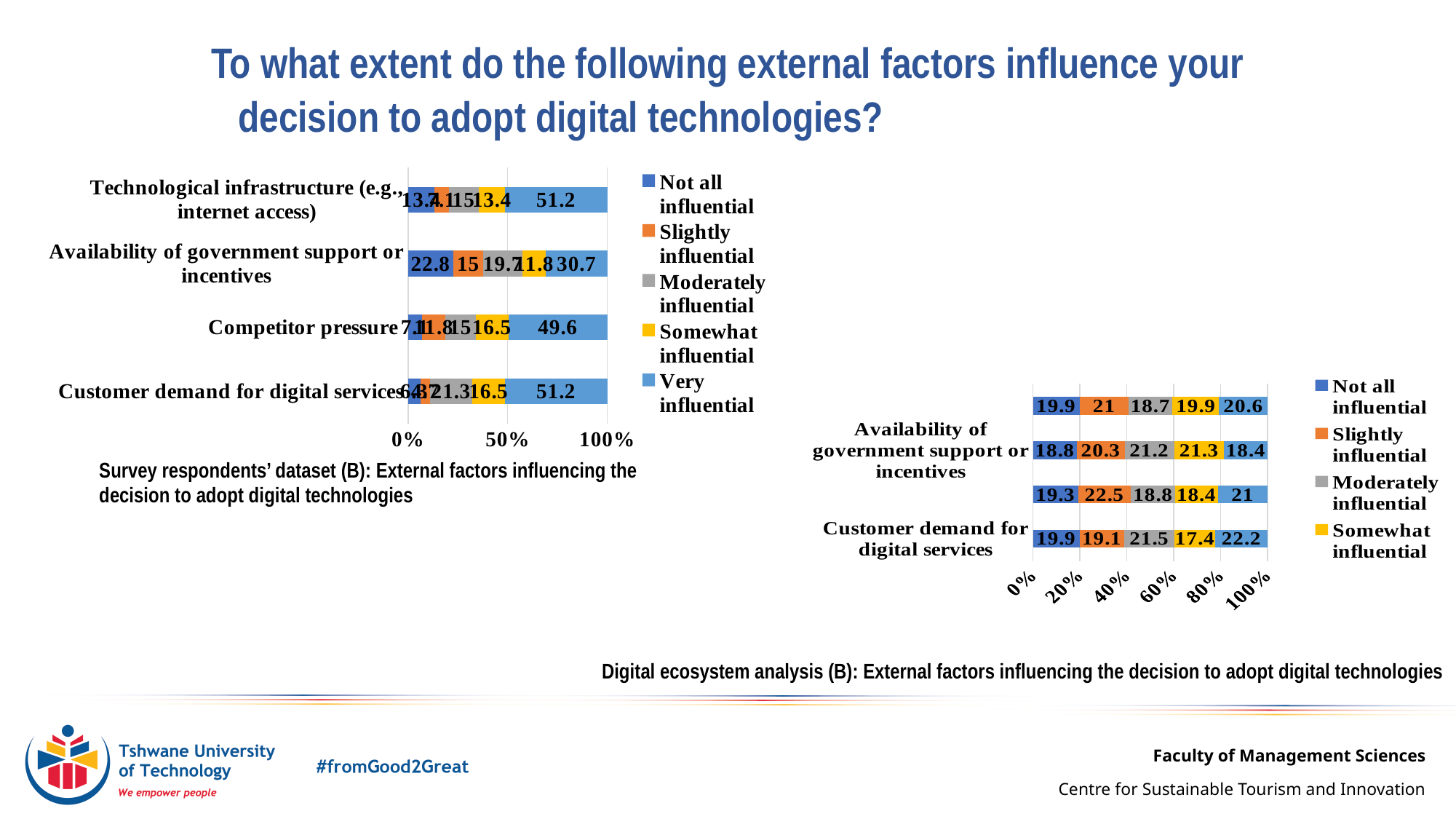
What kind of chart is the left chart (Survey respondents' dataset)? Stacked bar chart In the left chart (Survey respondents' dataset), which category has the lowest Very influential value? Availability of government support or incentives How many categories are shown in the left chart (Survey respondents' dataset)? 4 In the right chart (Digital ecosystem analysis), what is the Somewhat influential value for Availability of government support or incentives? 21.3 In the left chart (Survey respondents' dataset), which has a larger Very influential value: Competitor pressure or Availability of government support or incentives? Competitor pressure In the left chart (Survey respondents' dataset), what is the Not all influential value for Availability of government support or incentives? 22.8 In the left chart (Survey respondents' dataset), what is the Very influential value for Availability of government support or incentives? 30.7 In the right chart (Digital ecosystem analysis), which is larger for Customer demand for digital services: the Moderately influential value or the Somewhat influential value? Moderately influential In the right chart (Digital ecosystem analysis), what is the Moderately influential value for Customer demand for digital services? 21.5 In the left chart (Survey respondents' dataset), what percentage of respondents rated Competitor pressure as Very influential? 49.6 How many series does the legend of the left chart (Survey respondents' dataset) list? 5 In the left chart (Survey respondents' dataset), what is the difference between the Very influential values for Competitor pressure and Availability of government support or incentives? 18.9